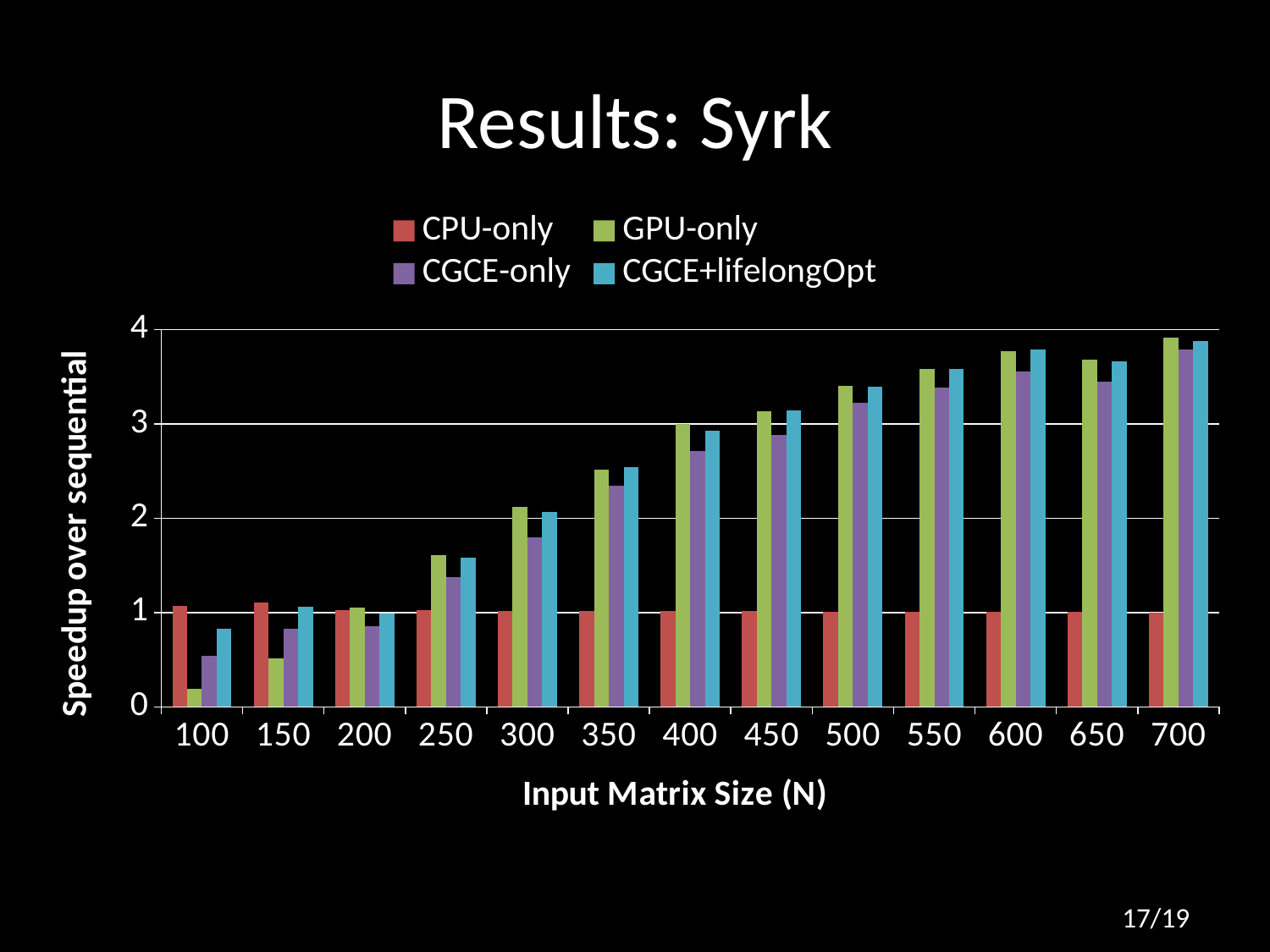
What is the title of the y axis? Speedup over sequential At N=100, which is larger: the CPU-only speedup or the CGCE-only speedup? CPU-only Is the GPU-only speedup at N=100 greater or less than 1? less At which input matrix size is the GPU-only speedup highest? 700 What kind of chart is shown on the slide? bar chart Is the GPU-only speedup at N=300 greater or less than 2? greater How many input matrix sizes are shown on the x axis? 13 Does the CGCE+lifelongOpt speedup generally rise or fall as the input matrix size increases from 100 to 700? rise At N=250, which is larger: the GPU-only speedup or the CGCE-only speedup? GPU-only At which input matrix size is the GPU-only speedup lowest? 100 How many series does the legend list? 4 Is the CGCE-only speedup at N=400 greater or less than 3? less